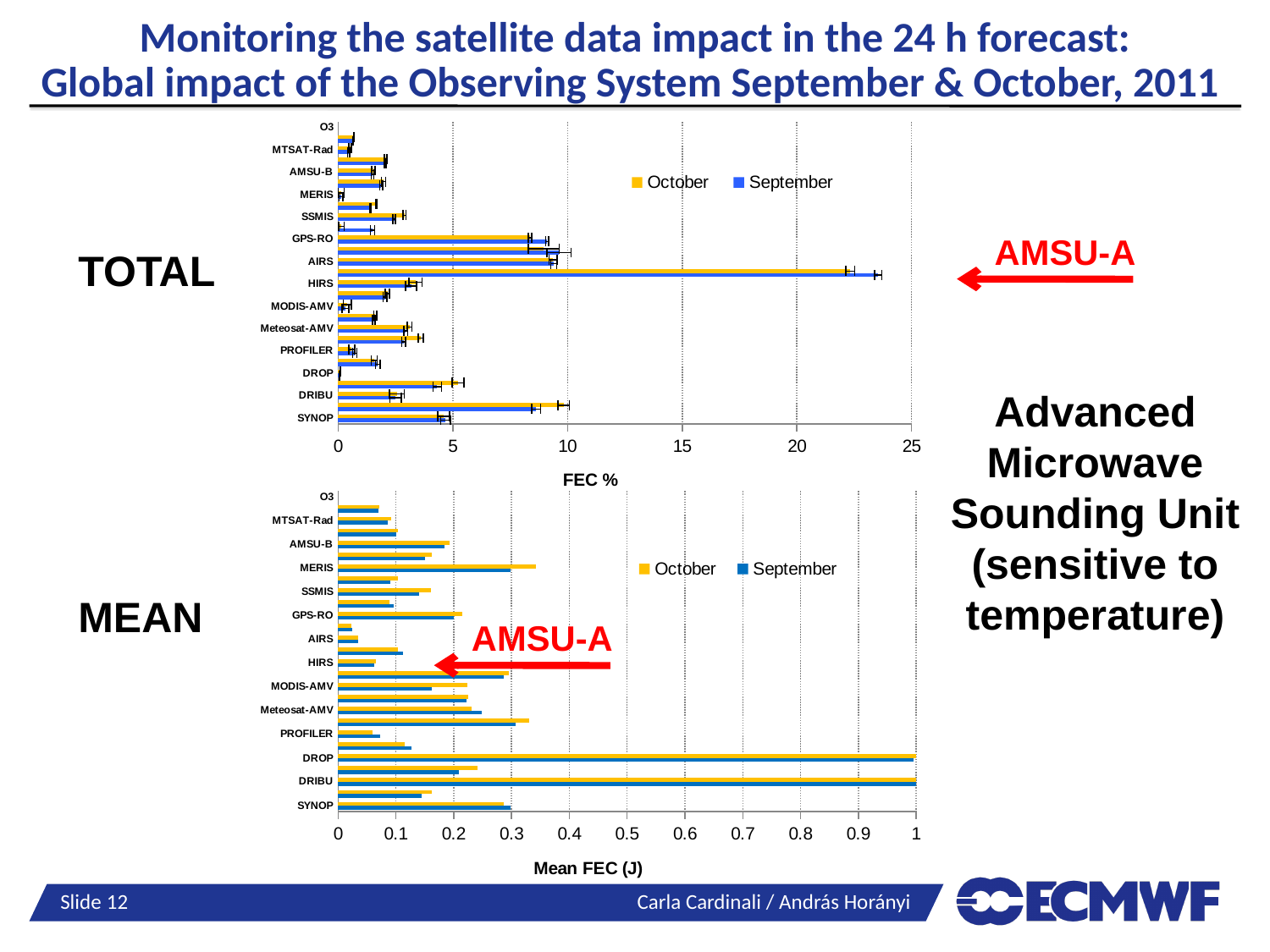
In the TOTAL chart, which observing system does the red arrow point to? AMSU-A In the TOTAL chart, is the October value for HIRS greater or less than 5? less In the MEAN chart, is the October value for AIRS greater or less than 0.1? less What kind of chart is the TOTAL chart at the top of the slide? Bar chart In the TOTAL chart, which has the larger October value, AIRS or HIRS? AIRS In the MEAN chart, which has the larger value for MERIS, October or September? October In the TOTAL chart, is the October value for AIRS greater or less than 5? greater What is the x-axis title of the MEAN chart at the bottom of the slide? Mean FEC (J) In the TOTAL chart, which has the larger October value, GPS-RO or MERIS? GPS-RO How many series does the legend of the MEAN chart list? 2